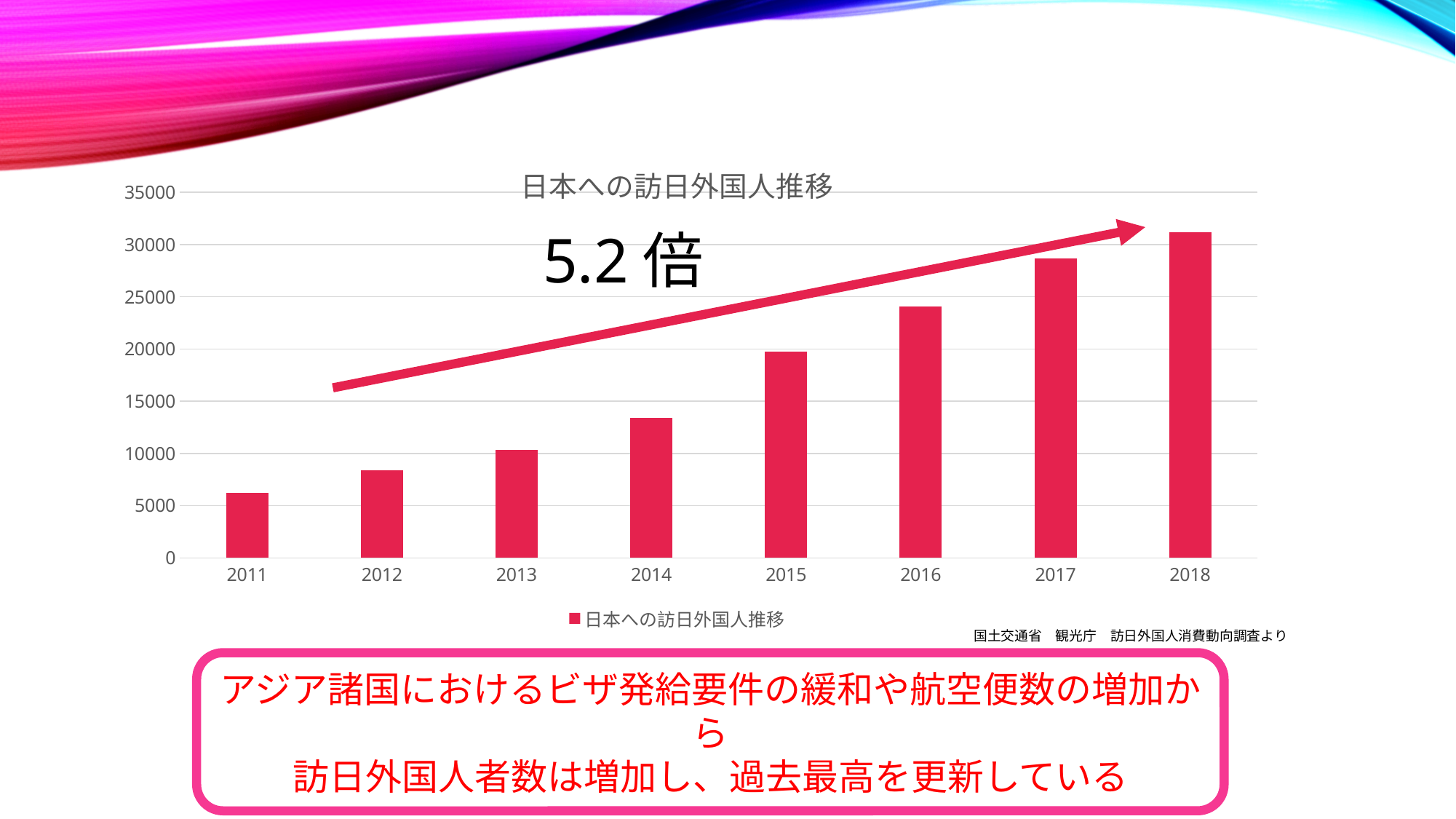
Is the value for 2018 greater or less than 30000? greater Is the value for 2011 greater or less than 10000? less How many series does the legend list? 1 What kind of chart is shown on the slide? bar chart How many years are shown on the x axis of the chart? 8 Which is larger, the value for 2016 or the value for 2014? 2016 Which year has the lowest value? 2011 What is the title of the chart? 日本への訪日外国人推移 Do the values rise or fall from 2011 to 2018? rise Is the value for 2013 greater or less than 15000? less Which year has the highest value? 2018